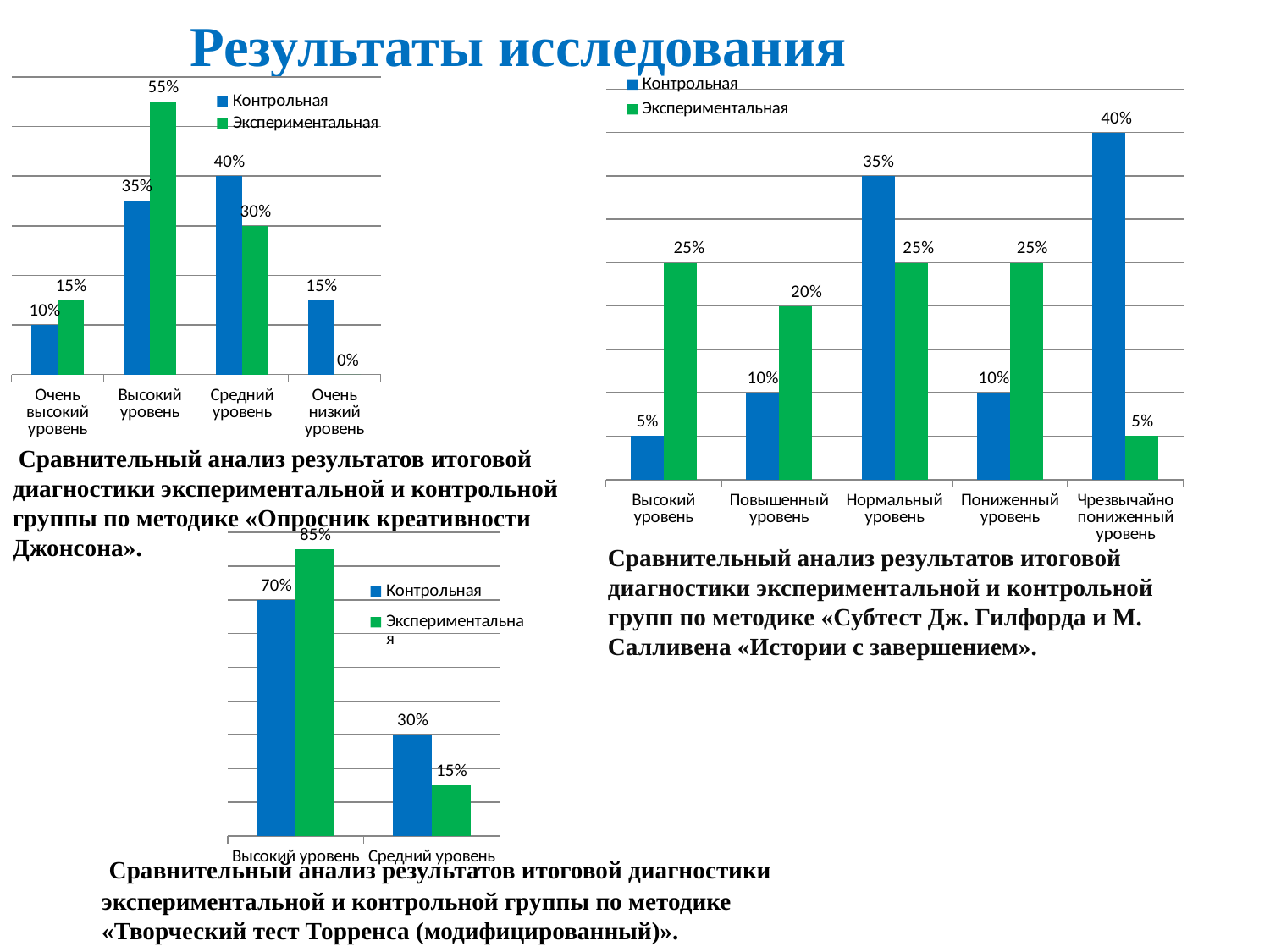
In the bottom-left chart (Творческий тест Торренса), what is the value for Экспериментальная at Высокий уровень? 85% What kind of chart is the bottom-left chart (Творческий тест Торренса)? Bar chart In the right chart (Субтест Дж. Гилфорда и М. Салливена), which is larger at Нормальный уровень: Контрольная or Экспериментальная? Контрольная How many series does the legend of the right chart (Субтест Дж. Гилфорда и М. Салливена) list? 2 In the top-left chart (Опросник креативности Джонсона), how many categories are shown on the x axis? 4 In the right chart (Субтест Дж. Гилфорда и М. Салливена), how many categories are shown on the x axis? 5 In the right chart (Субтест Дж. Гилфорда и М. Салливена), which category has the lowest value for Контрольная? Высокий уровень In the top-left chart (Опросник креативности Джонсона), what is the difference between Экспериментальная and Контрольная at Высокий уровень? 20% In the bottom-left chart (Творческий тест Торренса), what is the difference between Контрольная and Экспериментальная at Средний уровень? 15% In the right chart (Субтест Дж. Гилфорда и М. Салливена), what is the value for Контрольная at Чрезвычайно пониженный уровень? 40% In the top-left chart (Опросник креативности Джонсона), what is the value for Экспериментальная at Высокий уровень? 55% In the top-left chart (Опросник креативности Джонсона), what is the value for Контрольная at Средний уровень? 40%